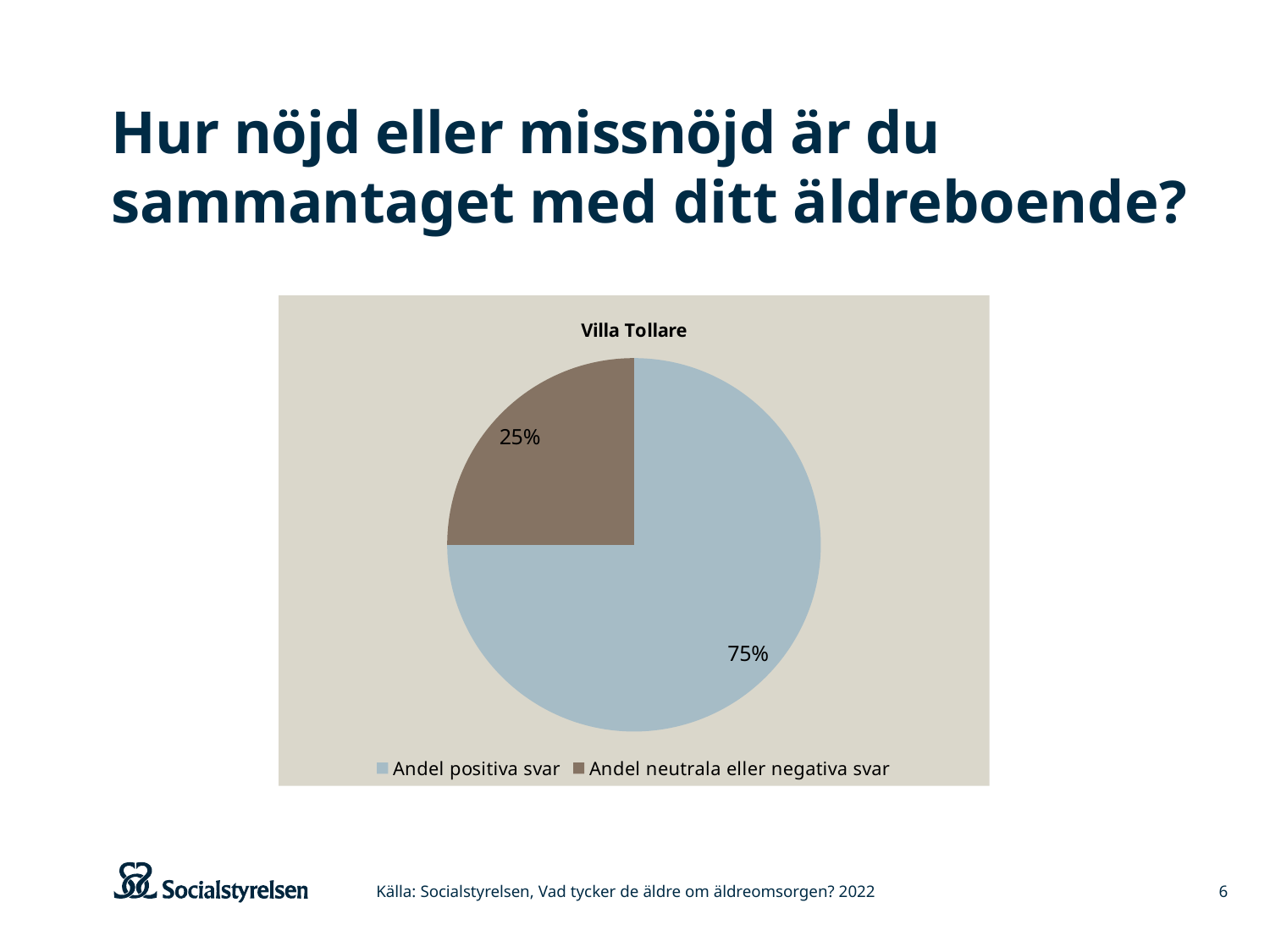
What share of the pie is 'Andel neutrala eller negativa svar'? 25% What is the title of the chart? Villa Tollare What is the difference between the share of 'Andel positiva svar' and 'Andel neutrala eller negativa svar'? 50% Which is larger: 'Andel positiva svar' or 'Andel neutrala eller negativa svar'? Andel positiva svar How many slices does the pie chart have? 2 Which slice is the smallest? Andel neutrala eller negativa svar What kind of chart is shown on the slide? pie chart What share of the pie is 'Andel positiva svar'? 75% Which slice is the largest? Andel positiva svar How many entries does the legend list? 2 Which legend entry is shown in brown? Andel neutrala eller negativa svar